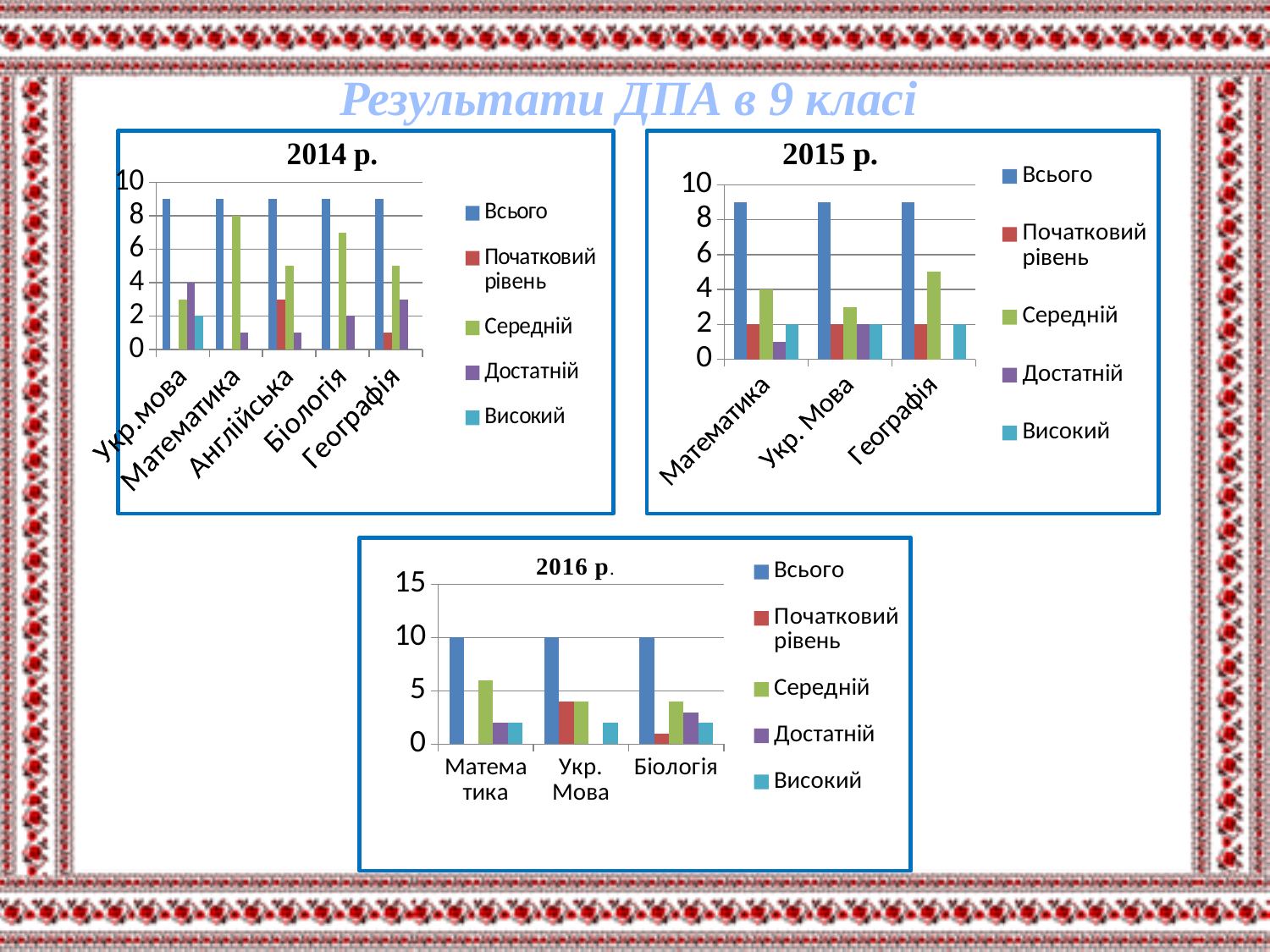
How many categories are shown on the x axis of the 2014 р. chart? 5 In the 2014 р. chart, is the value of Всього for Укр.мова greater or less than 8? greater What is the title of the chart in the top-left of the slide? 2014 р. What kind of chart is the 2014 р. chart? bar chart How many series does the legend of the 2016 р. chart list? 5 In the 2016 р. chart, is the value of Середній for Математика greater or less than 5? greater In the 2015 р. chart, which is larger: Середній for Географія or Середній for Укр. Мова? Географія In the 2015 р. chart, what is the value of Середній for Математика? 4 In the 2014 р. chart, what is the value of Середній for Математика? 8 In the 2016 р. chart, what is the value of Всього for Математика? 10 How many categories are shown on the x axis of the 2015 р. chart? 3 In the 2014 р. chart, which category has the highest Середній value? Математика